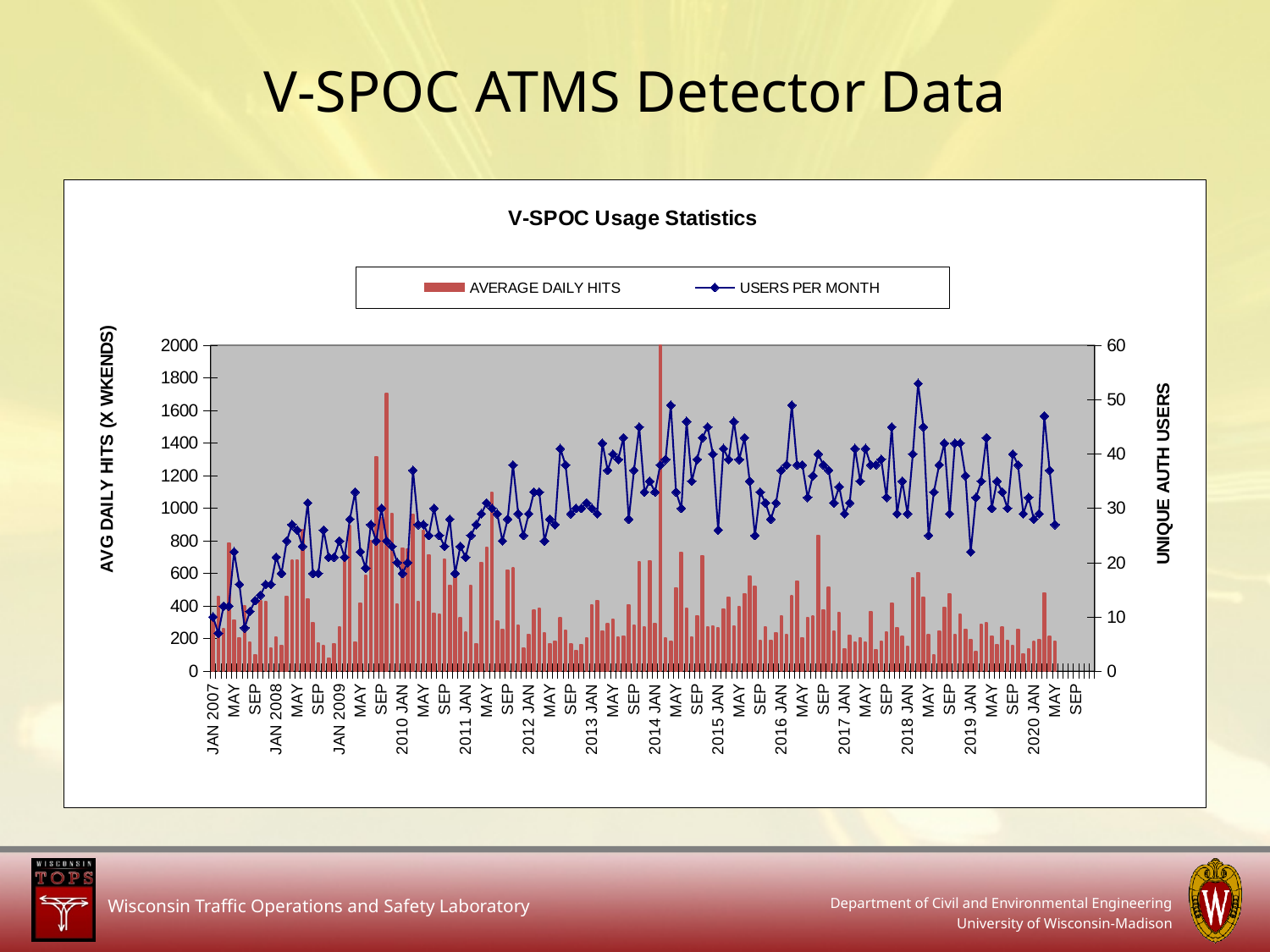
Overall, does the USERS PER MONTH line rise or fall from JAN 2007 to 2020? rise What is the highest value shown on the right vertical axis? 60 Which series is drawn as bars? AVERAGE DAILY HITS Is the USERS PER MONTH value for JAN 2007 greater or less than 20? less What kind of chart is this? Combined bar and line chart What is the title of the chart? V-SPOC Usage Statistics Is the AVERAGE DAILY HITS value for JAN 2014 greater or less than 1800? less How many series does the chart legend list? 2 Is the USERS PER MONTH value for JAN 2018 greater or less than 50? less